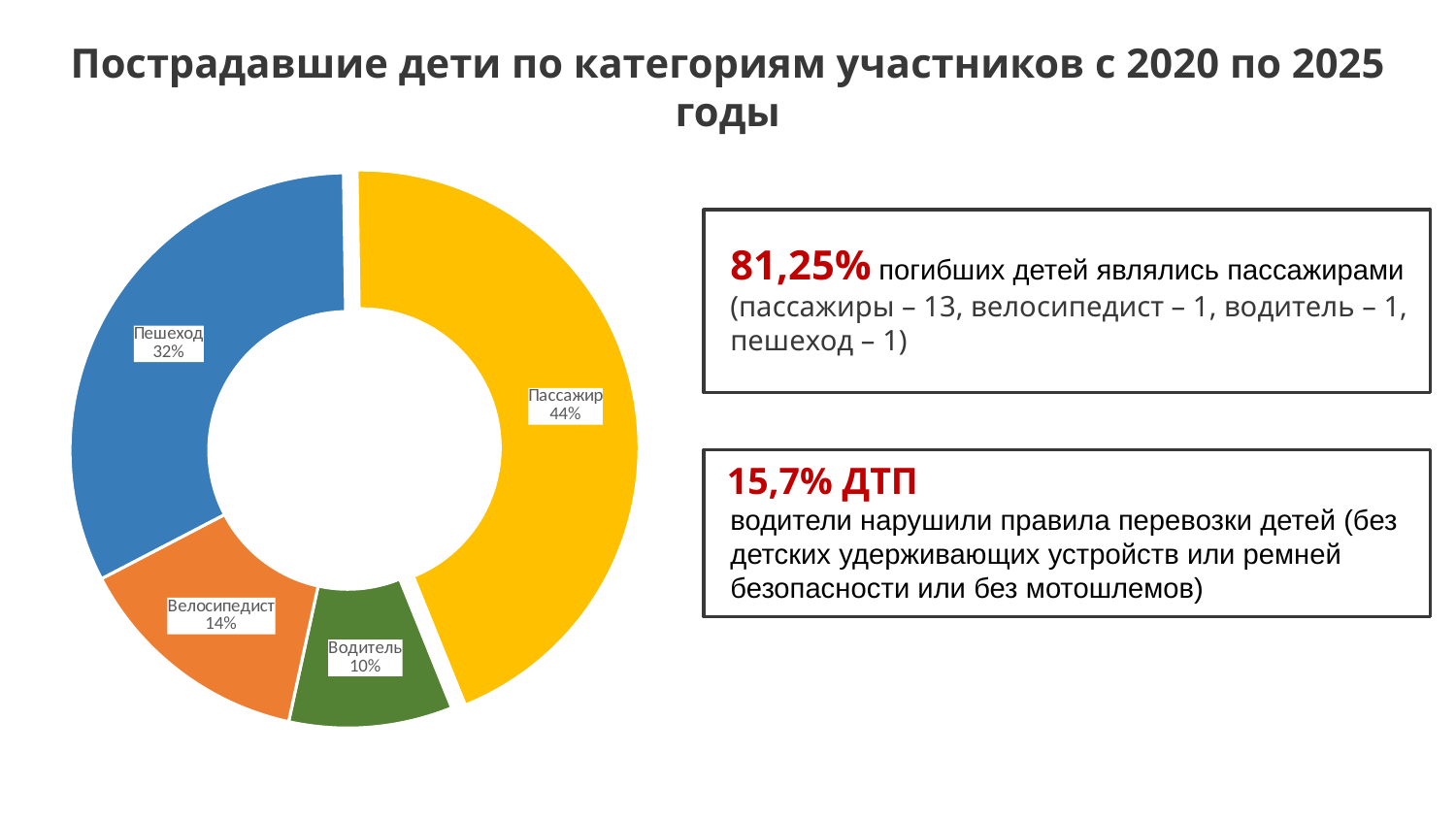
What kind of chart is shown on the slide? Pie chart (doughnut) Which category has the smallest share of the pie? Водитель What is the value shown for Водитель? 10% What share of the pie does the Пешеход slice represent? 32% What is the difference in percentage points between Пассажир and Пешеход? 12 What colour is the Пешеход slice? Blue What share of the pie does the Пассажир slice represent? 44% Which is larger, the share for Велосипедист or the share for Водитель? Велосипедист How many categories (slices) does the pie chart have? 4 What is the combined share of Велосипедист and Водитель? 24% What is the value shown for Велосипедист? 14% Which category has the largest share of the pie? Пассажир